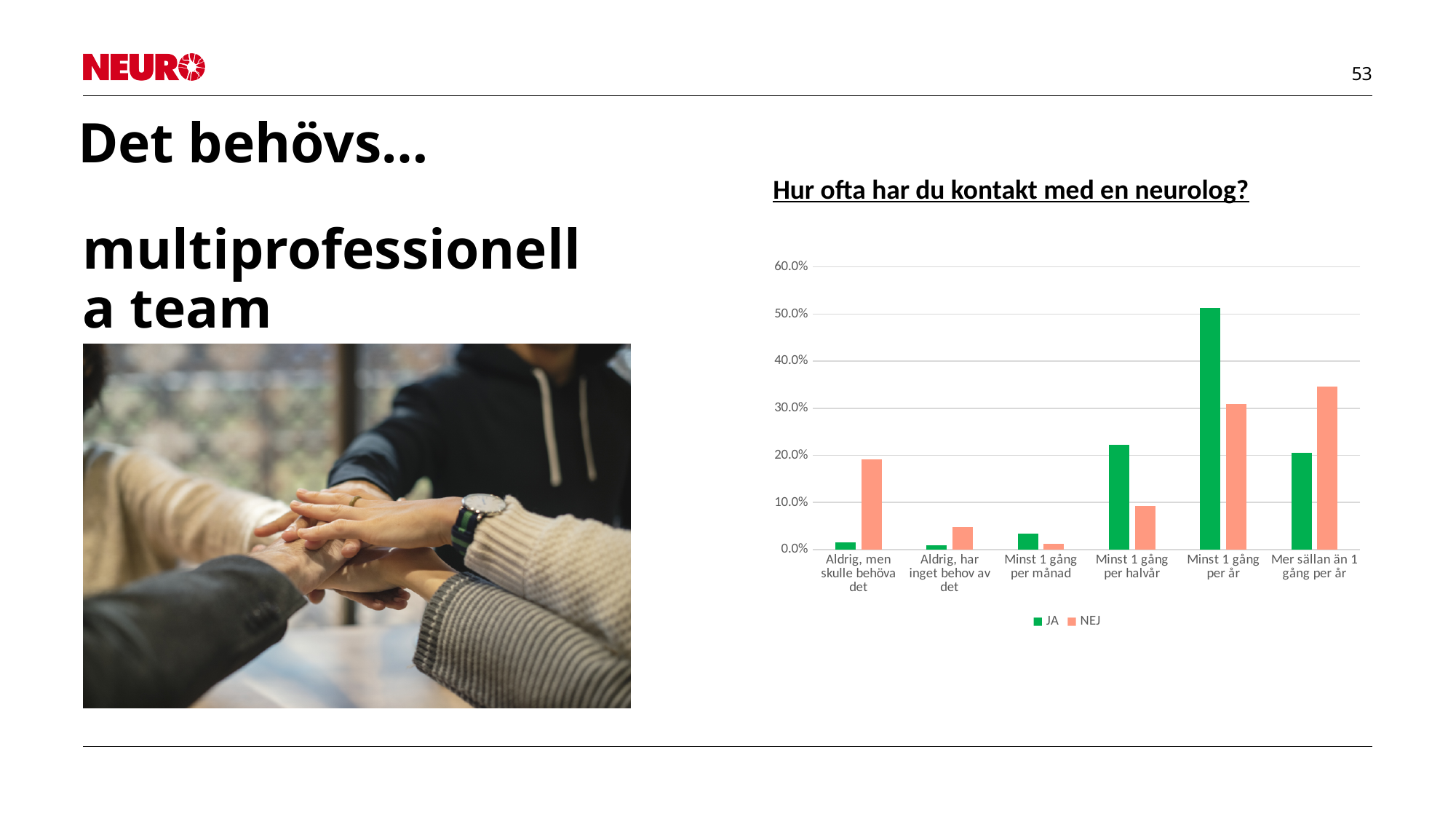
For 'Minst 1 gång per halvår', which is larger, the JA value or the NEJ value? JA Is the NEJ value for 'Mer sällan än 1 gång per år' greater or less than 30.0%? greater How many categories are shown along the x axis of the chart? 6 Is the JA value for 'Minst 1 gång per år' greater or less than 50.0%? greater Is the NEJ value for 'Aldrig, men skulle behöva det' greater or less than 20.0%? less Which category has the highest NEJ value? Mer sällan än 1 gång per år What is the title of the chart? Hur ofta har du kontakt med en neurolog? Which colour represents the NEJ series in the chart? orange (salmon) How many series does the chart legend list? 2 What kind of chart is shown on the slide? bar chart Which category has the lowest NEJ value? Minst 1 gång per månad Which category has the highest JA value? Minst 1 gång per år